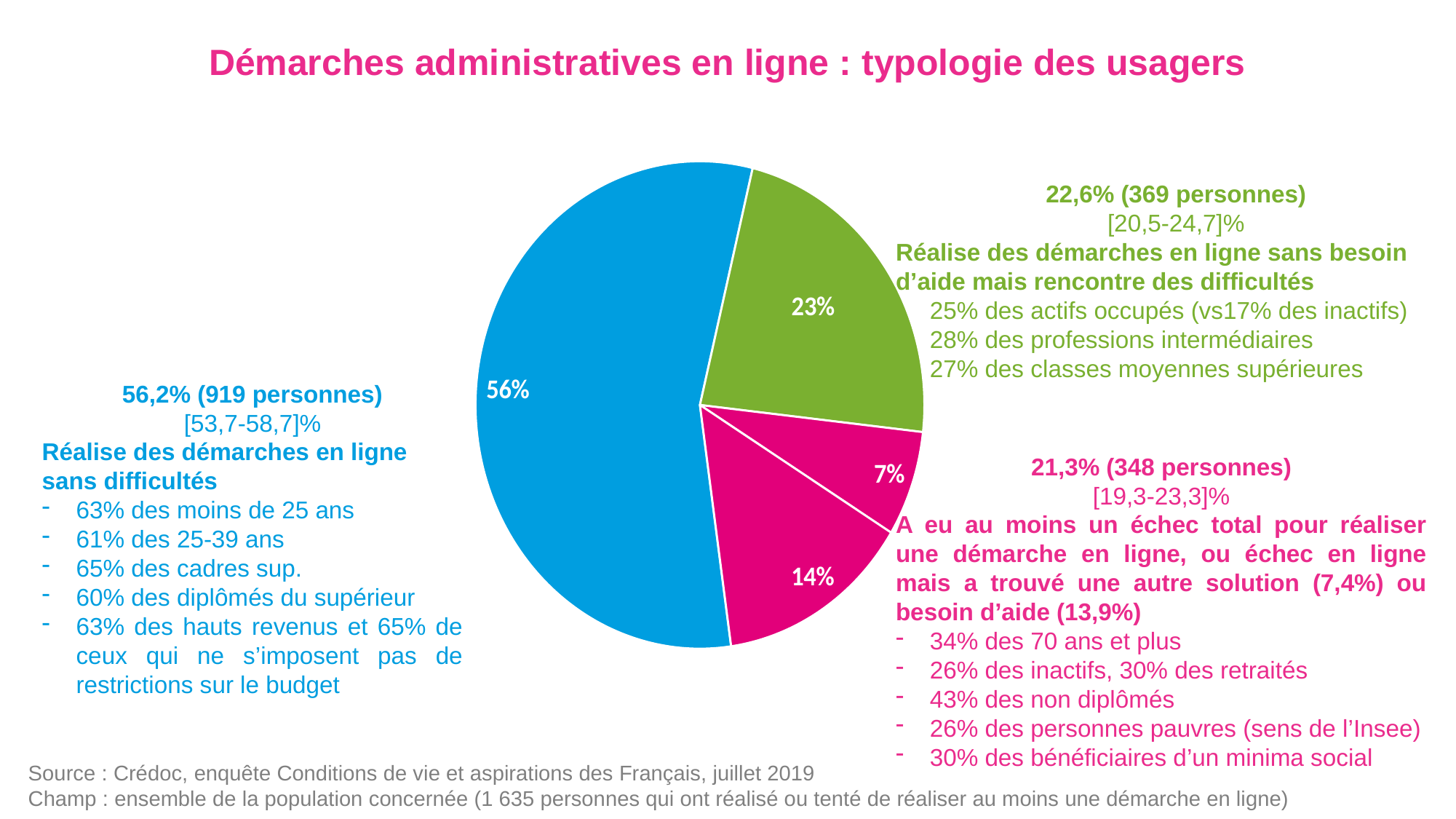
How many people are in the group 'Réalise des démarches en ligne sans difficultés' according to the annotation? 919 personnes What exact percentage is given in the annotation for the group 'Réalise des démarches en ligne sans besoin d'aide mais rencontre des difficultés'? 22,6% Which slice of the pie chart is the largest, by its printed label? 56% What is the title of the slide? Démarches administratives en ligne : typologie des usagers Which slice of the pie chart is the smallest, by its printed label? 7% Which of the two pink slices is larger, the one labelled 14% or the one labelled 7%? 14% What kind of chart is shown on the slide? Pie chart What percentage is printed on the blue slice of the pie chart? 56% What is the combined share of the two pink slices labelled 7% and 14%? 21% What percentage is printed on the green slice of the pie chart? 23% How many slices does the pie chart have? 4 What is the difference in percentage points between the blue slice (56%) and the green slice (23%)? 33